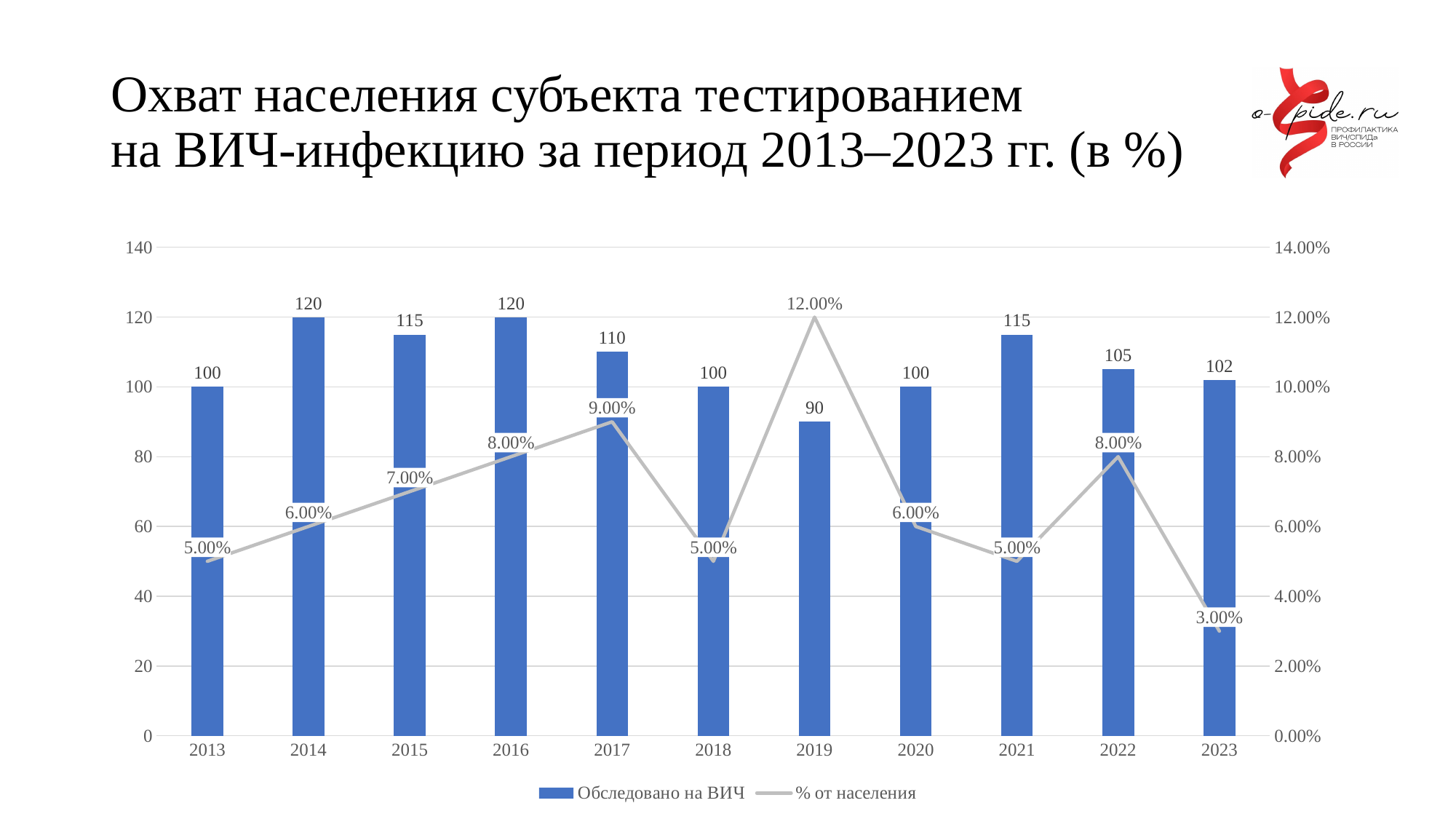
Which year has the lowest value of "% от населения"? 2023 What kinds of chart are combined on this slide? Bar chart and line chart What is the difference between the "Обследовано на ВИЧ" values for 2014 and 2019? 30 Which year has the lowest value of "Обследовано на ВИЧ"? 2019 Does the "% от населения" line rise or fall from 2013 to 2017? Rise How many years are shown on the x axis? 11 What is the value of "% от населения" for 2019? 12.00% How many series does the legend list? 2 What is the value of "Обследовано на ВИЧ" for 2017? 110 Which year has the highest value of "% от населения"? 2019 What is the value of "Обследовано на ВИЧ" for 2023? 102 Which is larger, the "Обследовано на ВИЧ" value for 2021 or for 2022? 2021